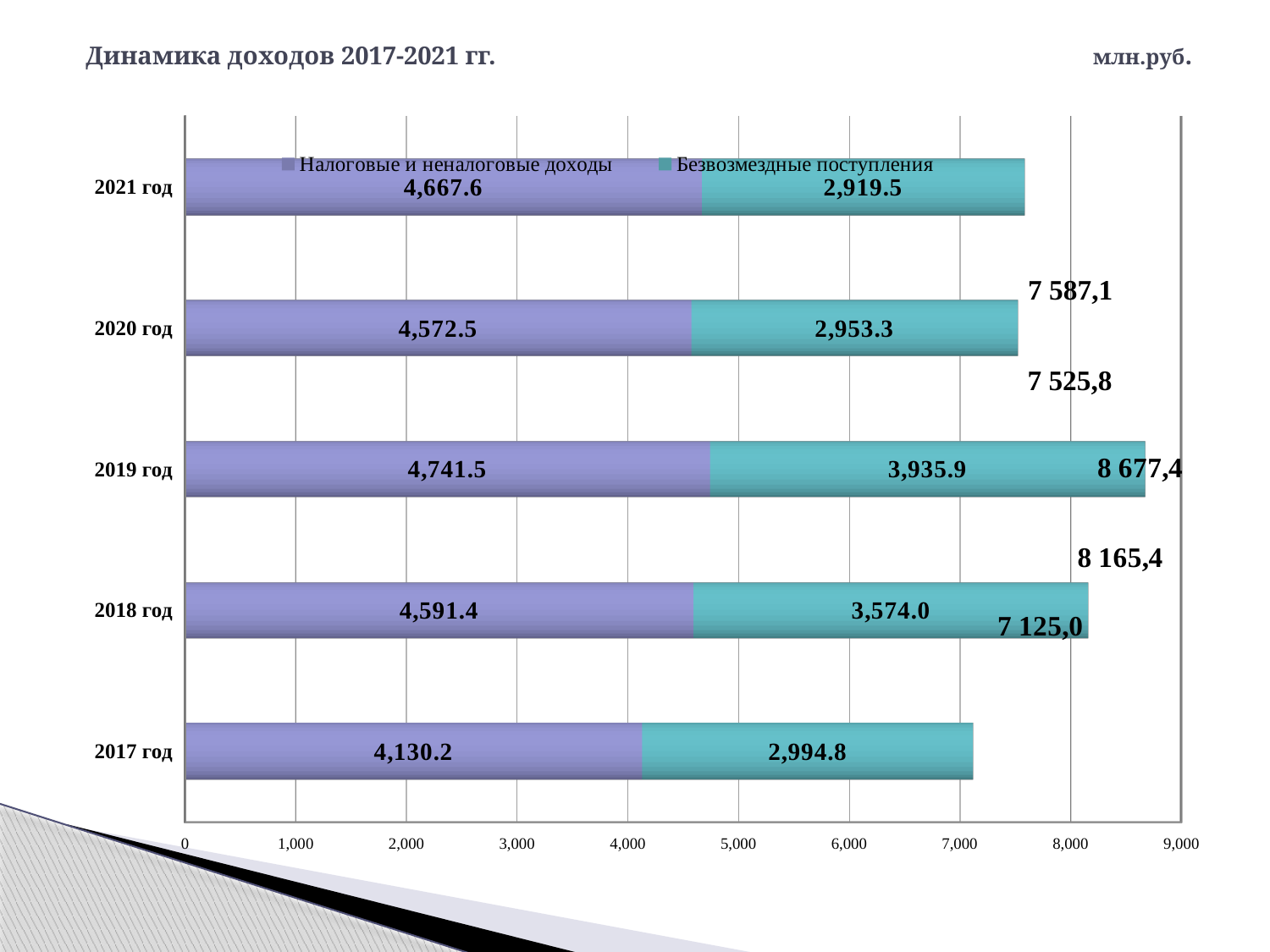
Is the total length of the bar for 2019 год greater or less than 8,000? greater What is the title of the chart? Динамика доходов 2017-2021 гг. Which is larger: Безвозмездные поступления in 2018 год or in 2020 год? 2018 год How many series does the legend list? 2 What is the difference between Безвозмездные поступления in 2019 год and in 2018 год? 361.9 What is the value of Налоговые и неналоговые доходы for 2017 год? 4,130.2 What is the value of Безвозмездные поступления for 2019 год? 3,935.9 Which year has the lowest value for Налоговые и неналоговые доходы? 2017 год How many years (categories) are shown on the chart? 5 What kind of chart is shown on the slide? bar chart Which year has the highest value for Налоговые и неналоговые доходы? 2019 год What is the total of the stacked bar for 2019 год? 8,677.4